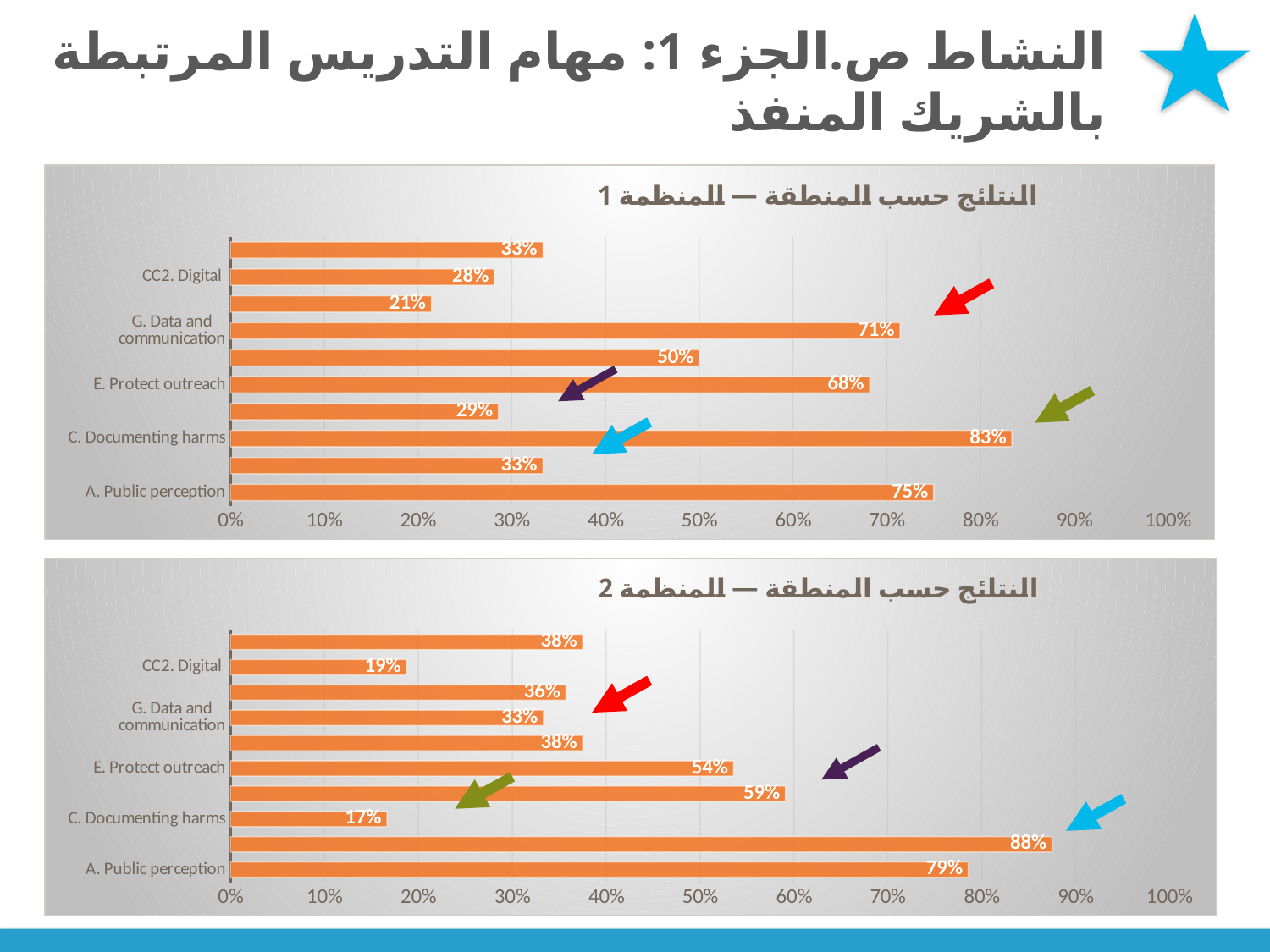
What type of chart is used on this slide? Bar chart In the bottom chart (المنظمة 2), what is the value for E. Protect outreach? 54% In the top chart (المنظمة 1), what is the value for CC2. Digital? 28% In the top chart (المنظمة 1), which is larger: G. Data and communication or E. Protect outreach? G. Data and communication In the bottom chart (المنظمة 2), what is the value for A. Public perception? 79% How many bars are plotted in the top chart (المنظمة 1)? 10 In the bottom chart (المنظمة 2), what is the difference between A. Public perception and E. Protect outreach? 25% In the bottom chart (المنظمة 2), what is the largest value shown on any bar? 88% In the top chart (المنظمة 1), what is the difference between C. Documenting harms and A. Public perception? 8% In the bottom chart (المنظمة 2), which category has the lowest value? C. Documenting harms In the top chart (المنظمة 1), which labeled category has the highest value? C. Documenting harms In the top chart (المنظمة 1), what is the value for C. Documenting harms? 83%